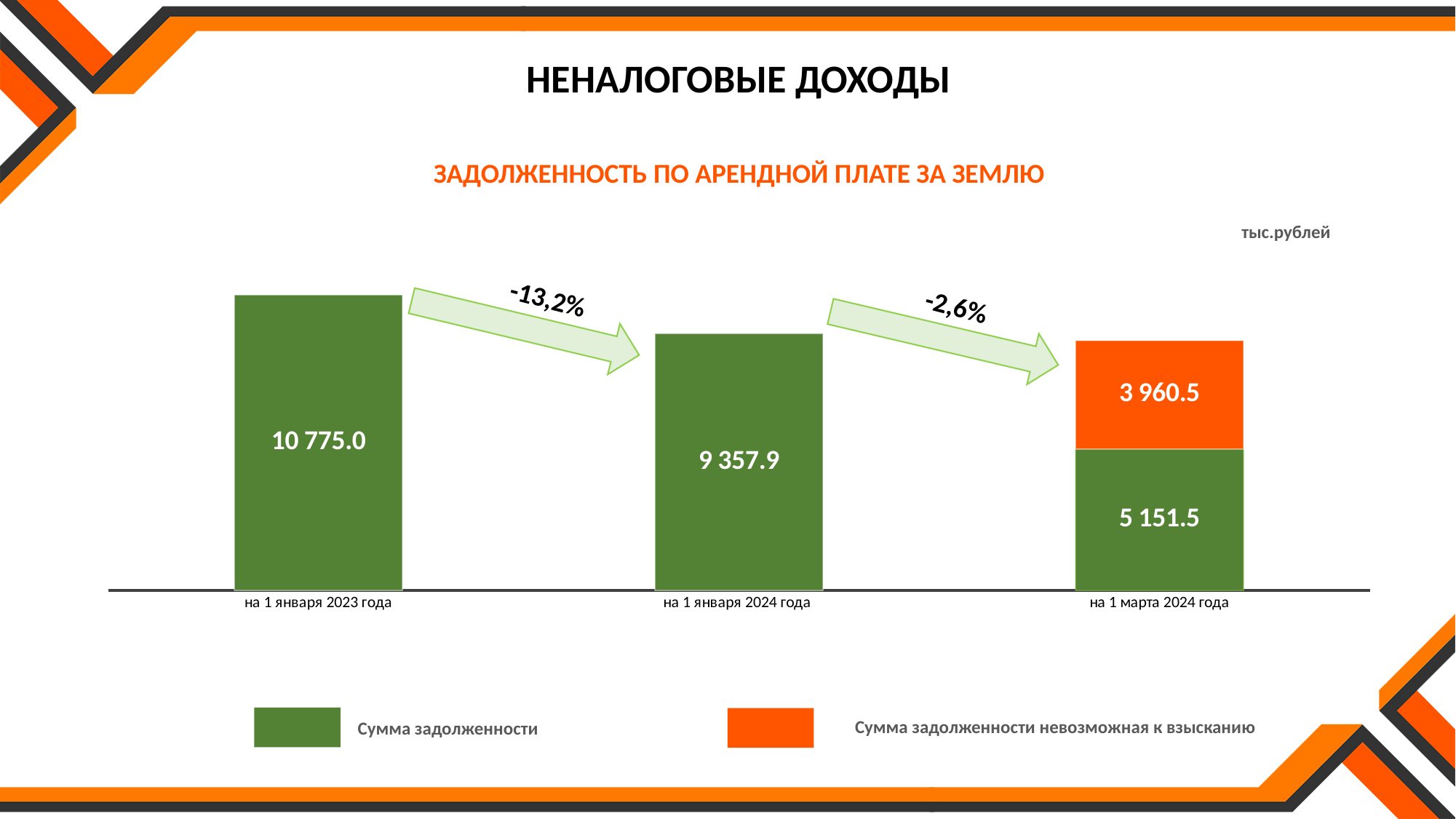
Which is larger for 'на 1 марта 2024 года': 'Сумма задолженности' or 'Сумма задолженности невозможная к взысканию'? Сумма задолженности What is the value of 'Сумма задолженности' for 'на 1 марта 2024 года'? 5 151.5 What is the value of 'Сумма задолженности' for 'на 1 января 2024 года'? 9 357.9 Which category has the highest value of 'Сумма задолженности'? на 1 января 2023 года What is the difference between the 'Сумма задолженности' values for 'на 1 января 2023 года' and 'на 1 января 2024 года'? 1 417.1 What is the value of 'Сумма задолженности' for 'на 1 января 2023 года'? 10 775.0 How many categories are shown on the x axis? 3 How many series does the legend list? 2 What is the total of the stacked bar for 'на 1 марта 2024 года'? 9 112.0 What is the value of 'Сумма задолженности невозможная к взысканию' for 'на 1 марта 2024 года'? 3 960.5 What kind of chart is shown on the slide? Stacked bar chart Which category has the lowest value of 'Сумма задолженности'? на 1 марта 2024 года